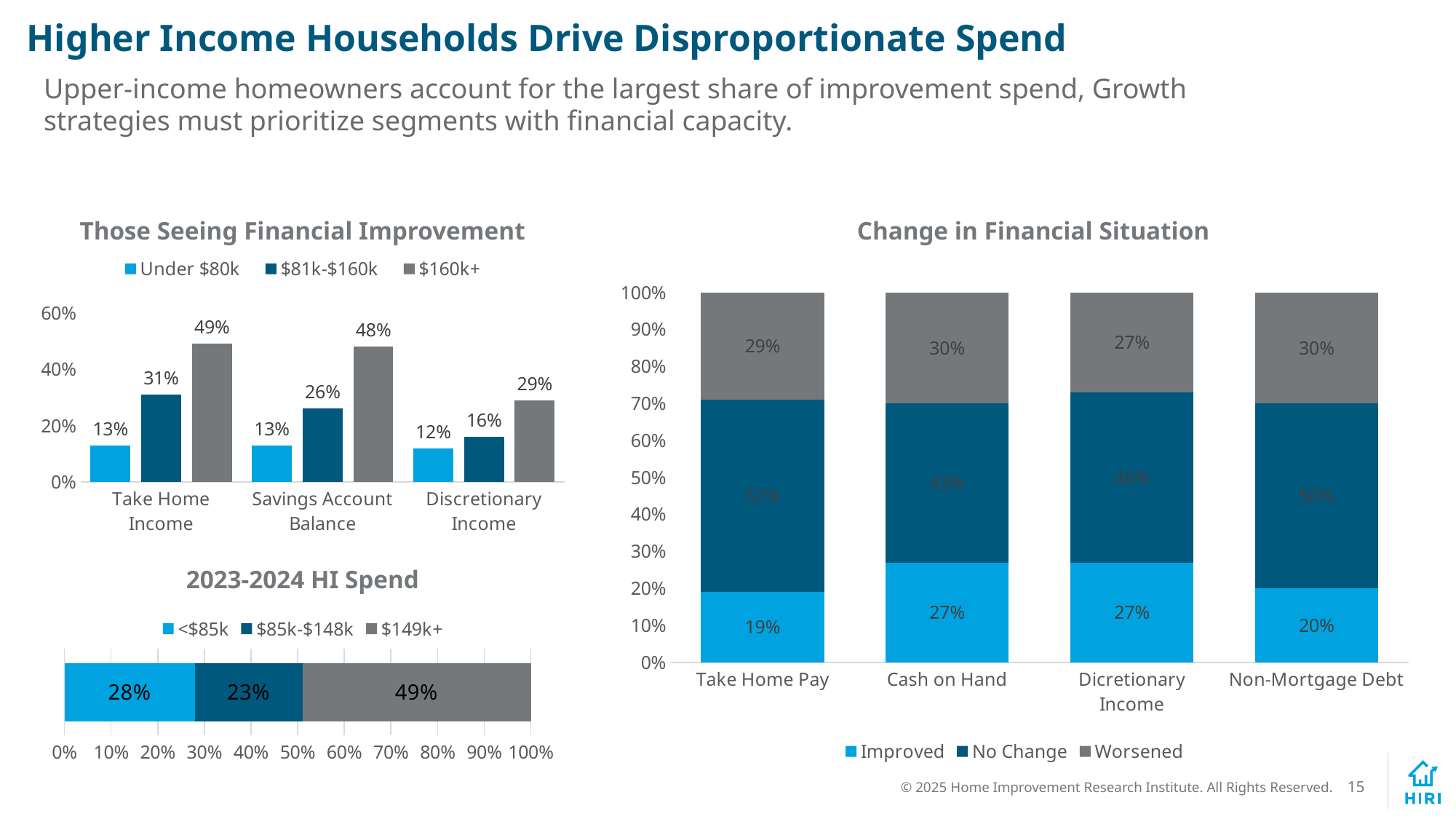
How many series does the legend of the 'Those Seeing Financial Improvement' chart list? 3 In the 'Change in Financial Situation' chart, what percentage reported Improved for Take Home Pay? 19% In the 'Change in Financial Situation' chart, is the Improved value for Cash on Hand larger or smaller than the Improved value for Non-Mortgage Debt? Larger In the 'Those Seeing Financial Improvement' chart, which income group has the lowest value for Discretionary Income? Under $80k In the '2023-2024 HI Spend' chart, what share of spend comes from the $149k+ group? 49% In the 'Those Seeing Financial Improvement' chart, what is the value for $160k+ households for Take Home Income? 49% In the '2023-2024 HI Spend' chart, which group has the smallest share of spend? $85k-$148k In the 'Those Seeing Financial Improvement' chart, what is the difference between the $160k+ and Under $80k values for Savings Account Balance? 35% In the 'Those Seeing Financial Improvement' chart, what is the value for $81k-$160k households for Savings Account Balance? 26% In the 'Change in Financial Situation' chart, what percentage reported Worsened for Discretionary Income? 27% What kind of chart is the '2023-2024 HI Spend' chart? Stacked horizontal bar chart In the 'Change in Financial Situation' chart, how many categories are shown on the x axis? 4